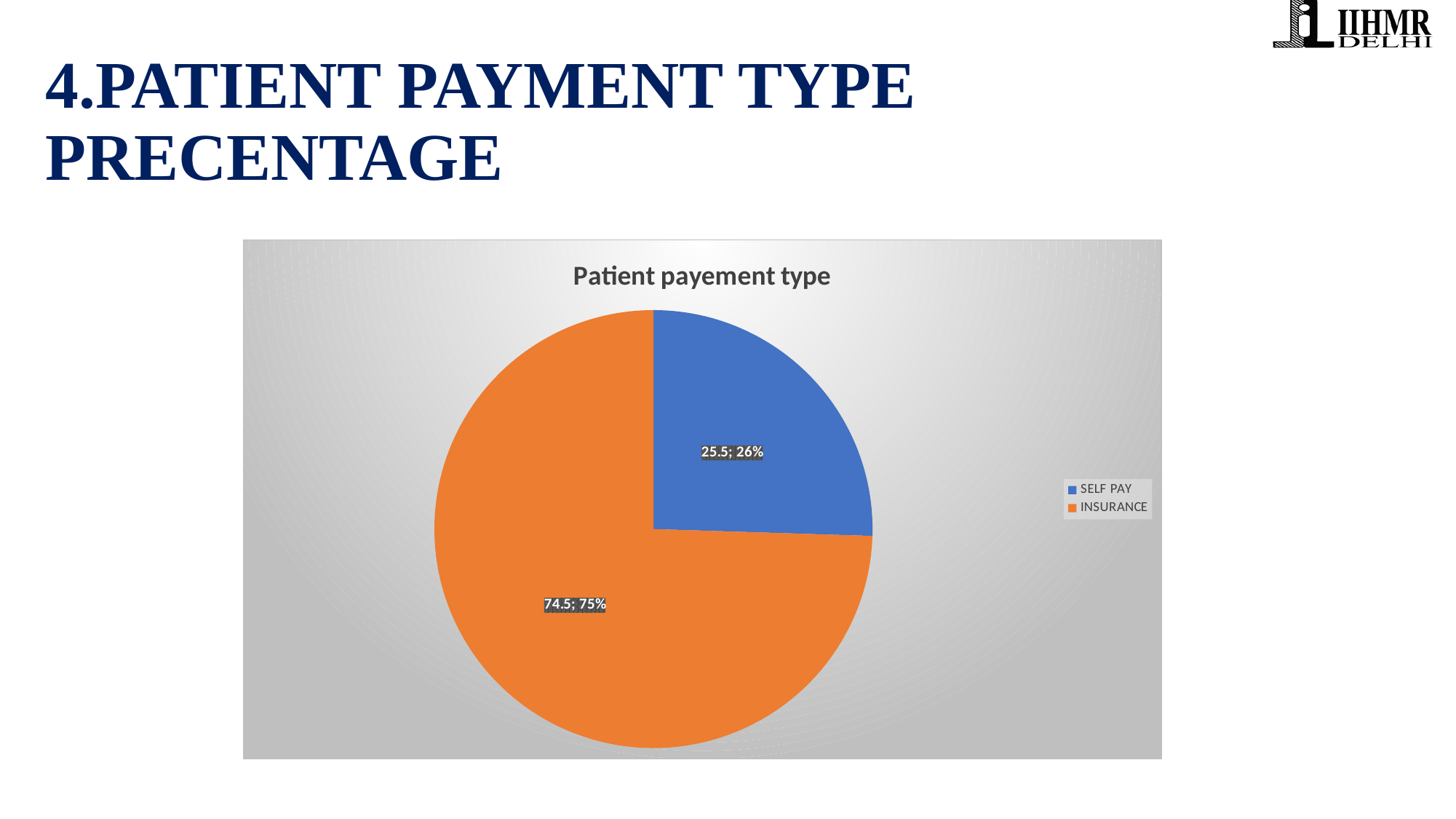
Which is larger, the value for SELF PAY or the value for INSURANCE? INSURANCE What value is shown for SELF PAY? 25.5 What is the title of the chart? Patient payement type What value is shown for INSURANCE? 74.5 How many categories does the pie chart have? 2 What is the difference between the INSURANCE value and the SELF PAY value? 49 Which payment type has the smallest slice? SELF PAY What kind of chart is shown on the slide? pie chart What percentage share of the pie does SELF PAY have? 26% Which payment type has the largest slice? INSURANCE What percentage share of the pie does INSURANCE have? 75% What colour is the INSURANCE slice? orange